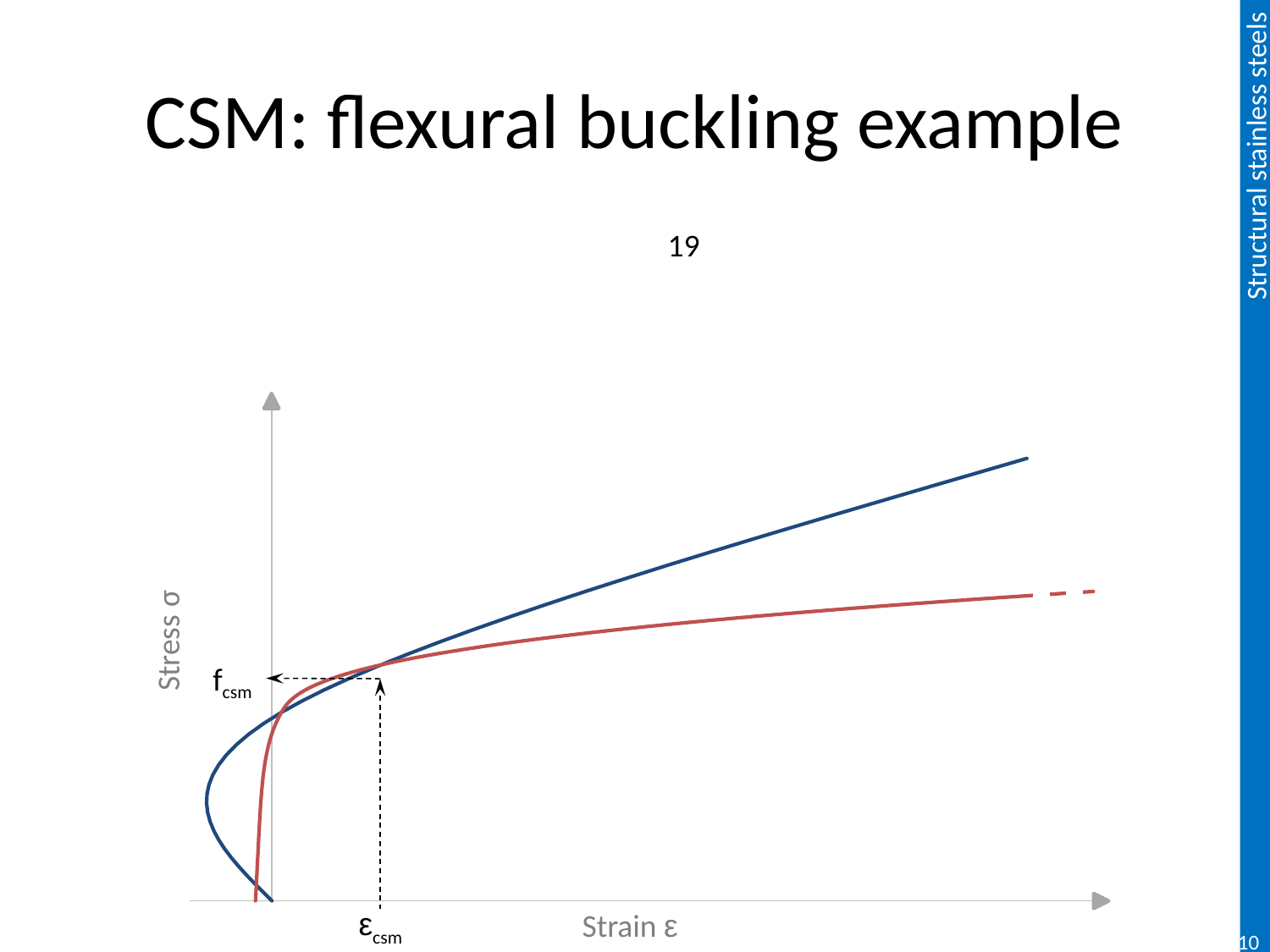
What is the label of the horizontal axis of the chart? Strain ε At large strain values on the right of the chart, which curve is higher, the blue one or the red one? The blue one What kind of chart is shown on the slide? Line chart Does the red curve rise or fall as strain increases along the x axis? Rise Which curve ends with a dashed segment at the right of the chart, the blue one or the red one? The red one Does the chart show any numeric tick values on its axes? No How many curves are plotted on the chart? 2 What label is marked on the stress axis at the point where the two curves intersect? fcsm What label is marked on the strain axis at the point where the two curves intersect? εcsm